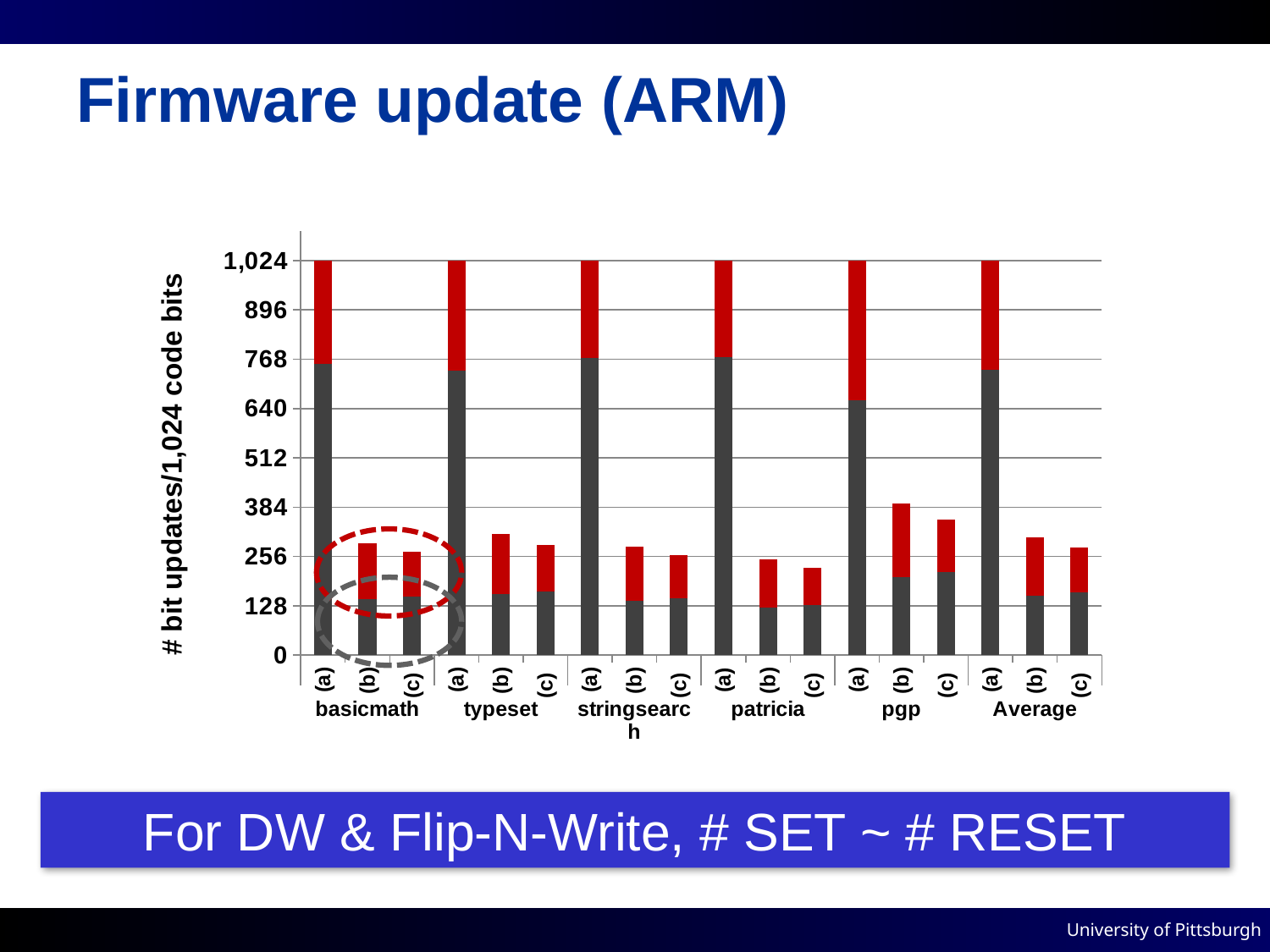
What is the total height of the (a) bar for Average? 1,024 Is the total value for the (b) bar of typeset greater or less than 256? greater What is the total height of the (a) bar for basicmath? 1,024 Is the total value for the (c) bar of pgp greater or less than 384? less Is the total value for the (b) bar of basicmath greater or less than 256? greater What kind of chart is shown on the slide? bar chart What is the label of the y axis? # bit updates/1,024 code bits How many bars are plotted in total on the chart? 18 Which is taller, the (c) bar for pgp or the (c) bar for patricia? pgp (c) How many benchmark groups are shown along the x axis? 6 Which is taller, the (b) bar for pgp or the (b) bar for basicmath? pgp (b)